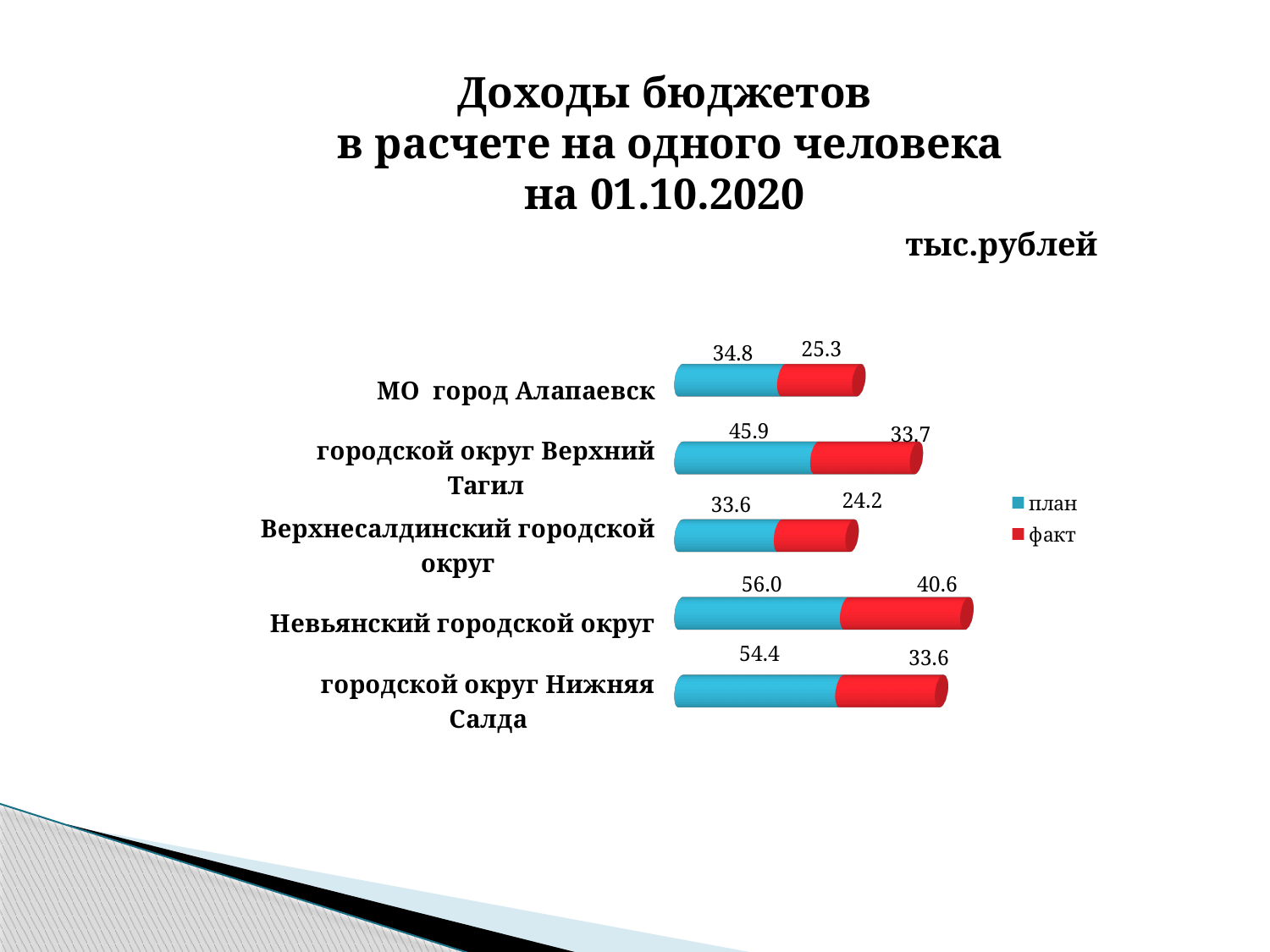
Which category has the highest план value? Невьянский городской округ How many categories are shown in the chart? 5 What is the total of the stacked bar for Верхнесалдинский городской округ? 57.8 Which is larger: the факт value for Невьянский городской округ or the факт value for городской округ Нижняя Салда? Невьянский городской округ What is the факт value for городской округ Нижняя Салда? 33.6 Which category has the lowest факт value? Верхнесалдинский городской округ What is the факт value for МО город Алапаевск? 25.3 How many series does the legend list? 2 What kind of chart is shown on the slide? Stacked bar chart What unit is stated for the values in the chart? тыс.рублей What is the difference between the план and факт values for городской округ Верхний Тагил? 12.2 What is the план value for Невьянский городской округ? 56.0